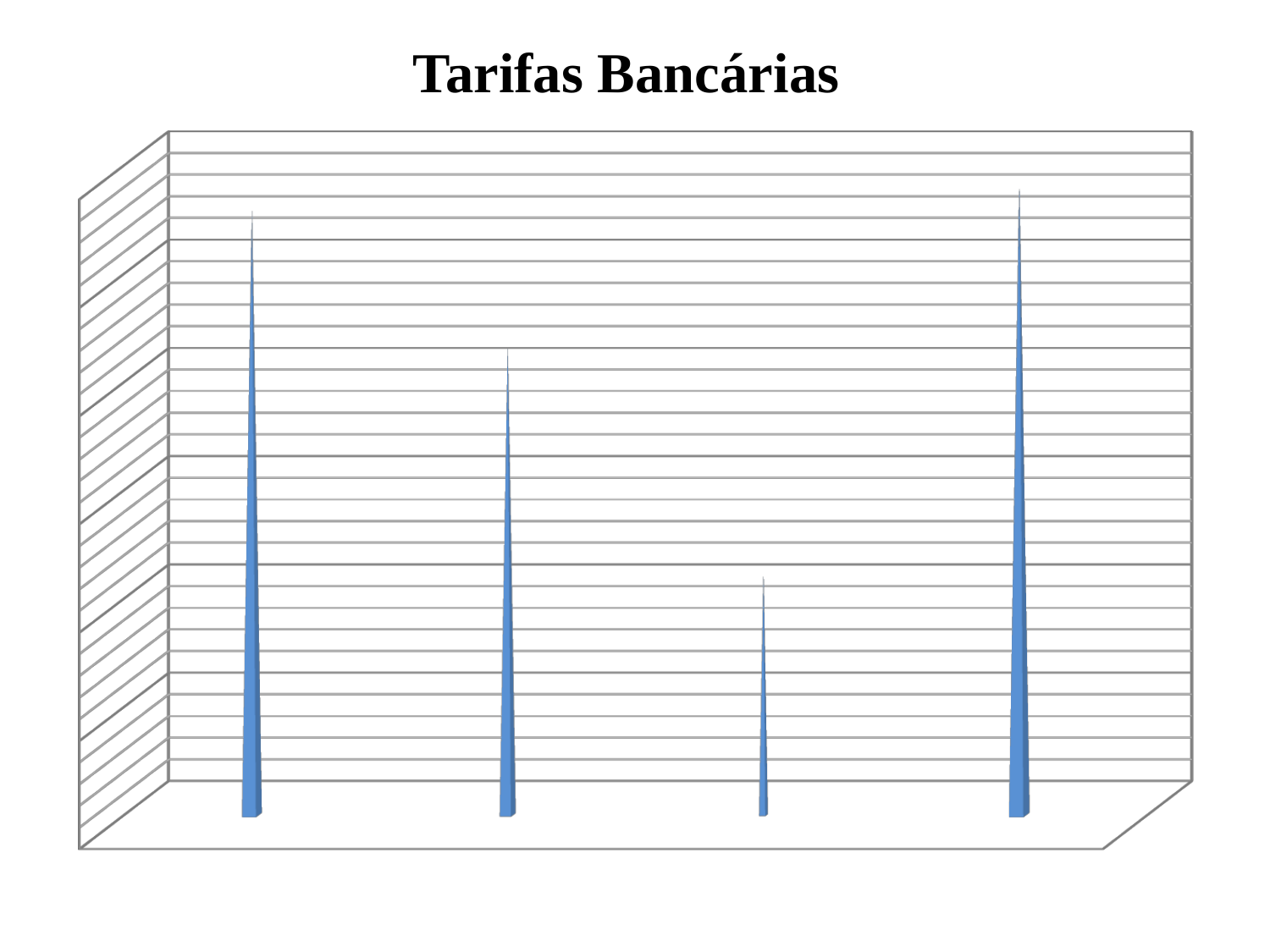
How many bars are plotted in the chart? 4 Is the first bar from the left taller or shorter than the second bar? taller Which bar, counting from the left, is the shortest? the third What is the title of the chart? Tarifas Bancárias Is the third bar from the left taller or shorter than the fourth bar? shorter What kind of chart is shown on the slide? bar chart Which bar, counting from the left, is the tallest? the fourth (rightmost) What colour are the bars in the chart? blue